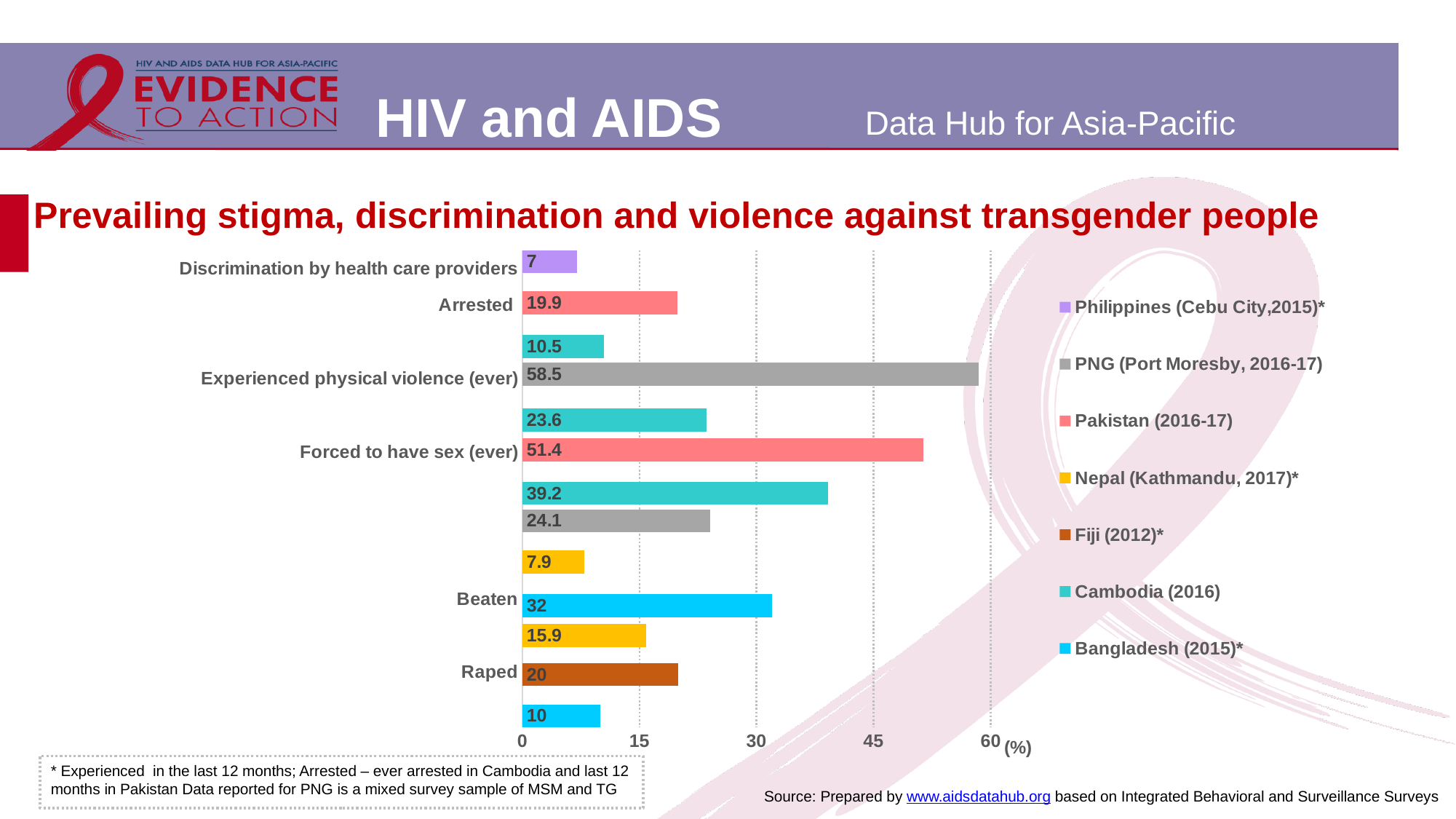
What kind of chart is shown on the slide? bar chart What is the difference between the PNG value for Experienced physical violence (ever) and the Pakistan value for Forced to have sex (ever)? 7.1 How many series does the legend list? 7 What is the value for Forced to have sex (ever) for Pakistan (2016-17)? 51.4 How many categories are shown on the vertical axis of the chart? 6 Is the value for Beaten for Bangladesh (2015) greater or less than 30? greater Which colour represents Cambodia (2016) in the legend? teal What is the value for Discrimination by health care providers (Philippines)? 7 What is the value for Experienced physical violence (ever) for PNG (Port Moresby, 2016-17)? 58.5 Which bar has the highest value in the chart? Experienced physical violence (ever), PNG (Port Moresby, 2016-17) at 58.5 What is the value for Raped for Fiji (2012)? 20 What is the value for Arrested for Pakistan (2016-17)? 19.9